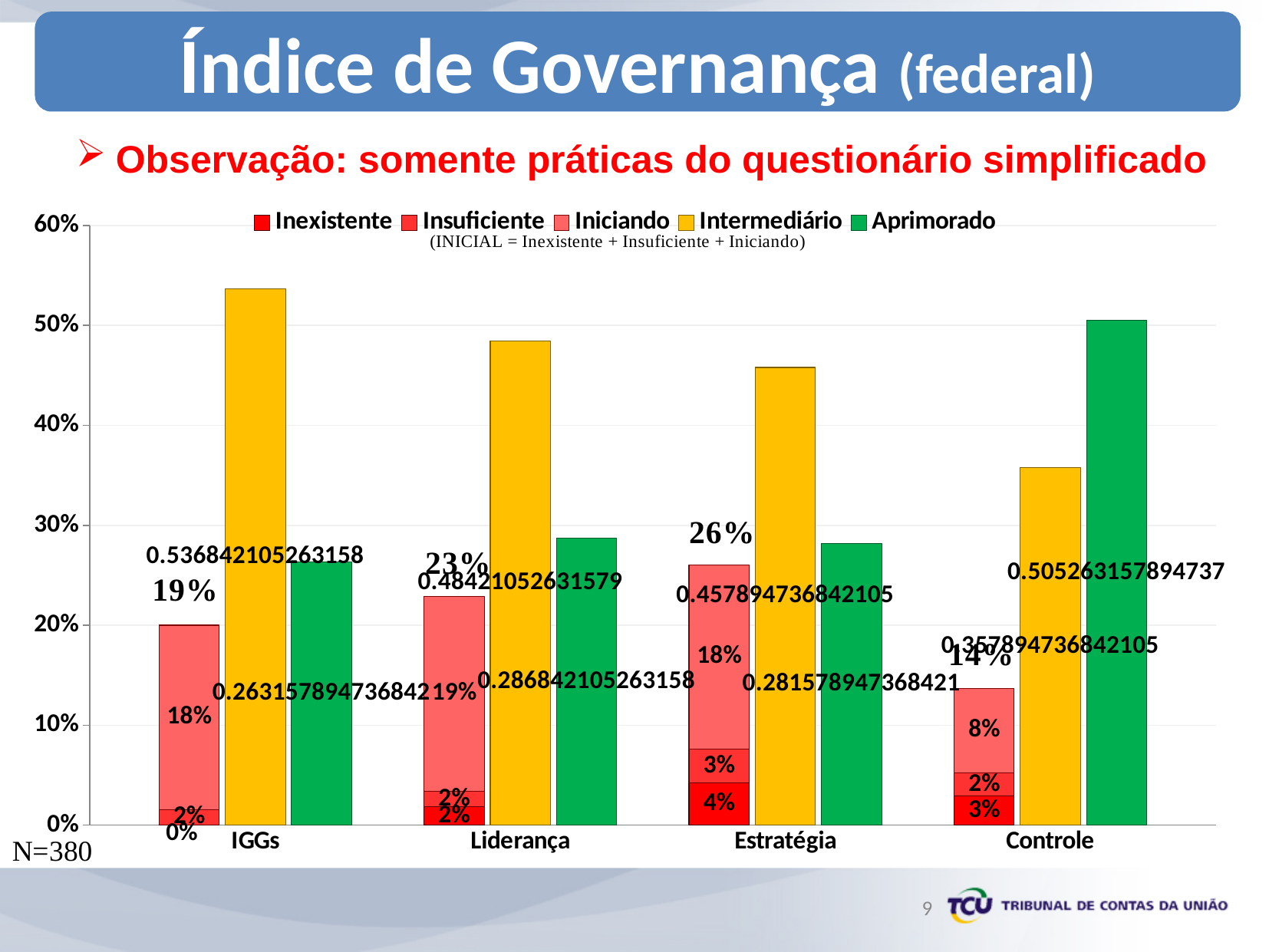
Which category has the lowest INICIAL total (Inexistente + Insuficiente + Iniciando)? Controle What kind of chart is shown on the slide? bar chart What is the Aprimorado value for Controle? 0.505263157894737 How many series does the legend list? 5 For Estratégia, which is larger: Intermediário or Aprimorado? Intermediário Which category has the highest Aprimorado value? Controle How many categories are shown on the x axis? 4 Is the Intermediário value for Liderança greater or less than 40%? greater What is the Intermediário value for IGGs? 0.536842105263158 What is the Inexistente value for Estratégia? 4% Which category has the highest Intermediário value? IGGs What is the Iniciando value for Controle? 8%